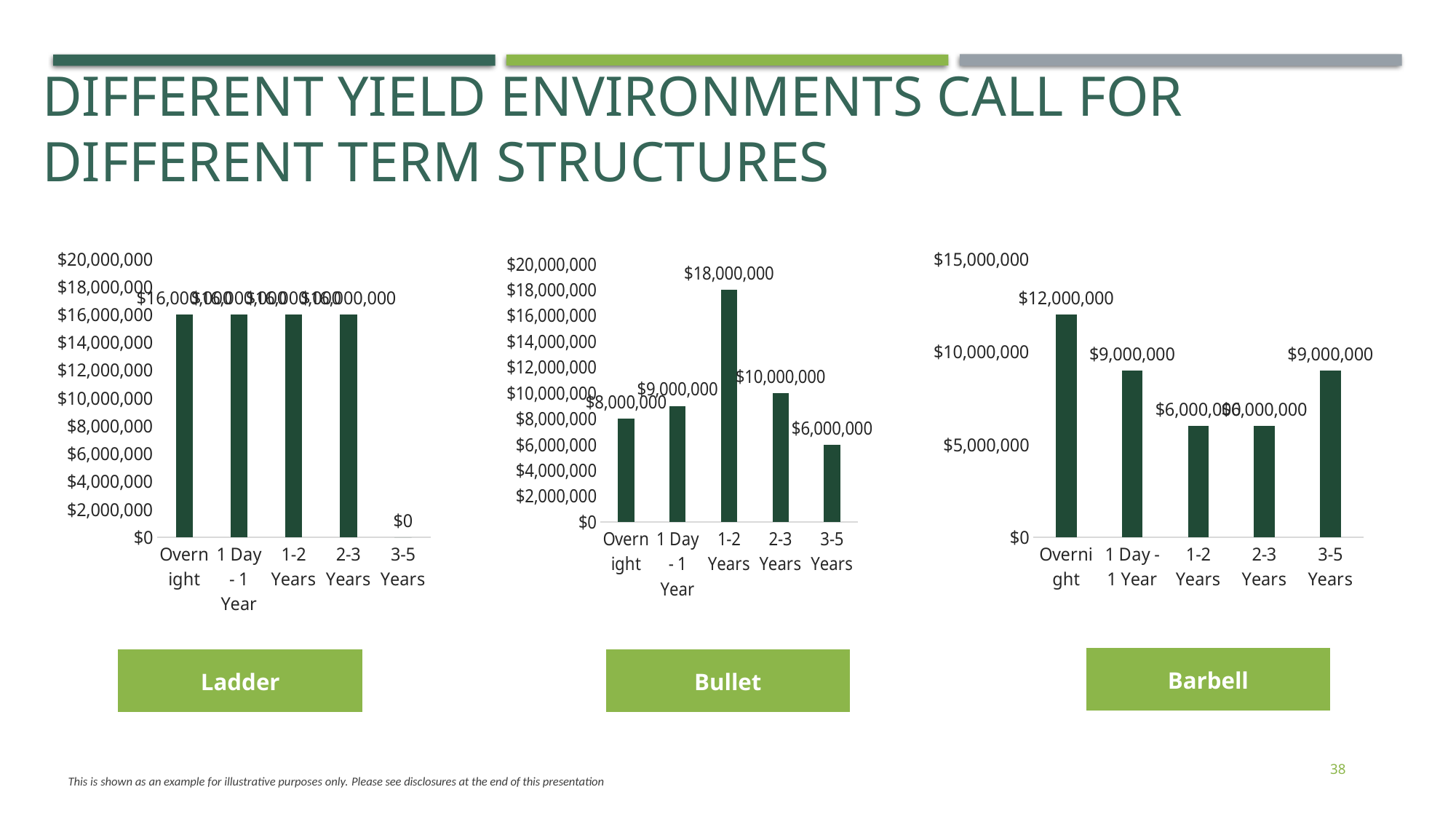
How many categories are shown on the x axis of the Ladder chart? 5 In the Bullet chart, what is the difference between the values for 1-2 Years and 3-5 Years? $12,000,000 In the Bullet chart, which category has the highest value? 1-2 Years In the Barbell chart, which category has the highest value? Overnight In the Bullet chart, which is larger, the value for Overnight or the value for 2-3 Years? 2-3 Years How many charts are shown on the slide? 3 In the Barbell chart, what is the difference between the values for Overnight and 1-2 Years? $6,000,000 In the Ladder chart, what is the value for 3-5 Years? $0 What type of chart is the Barbell chart? Bar chart In the Bullet chart, what is the value for 1-2 Years? $18,000,000 In the Bullet chart, which category has the lowest value? 3-5 Years In the Barbell chart, what is the value for Overnight? $12,000,000